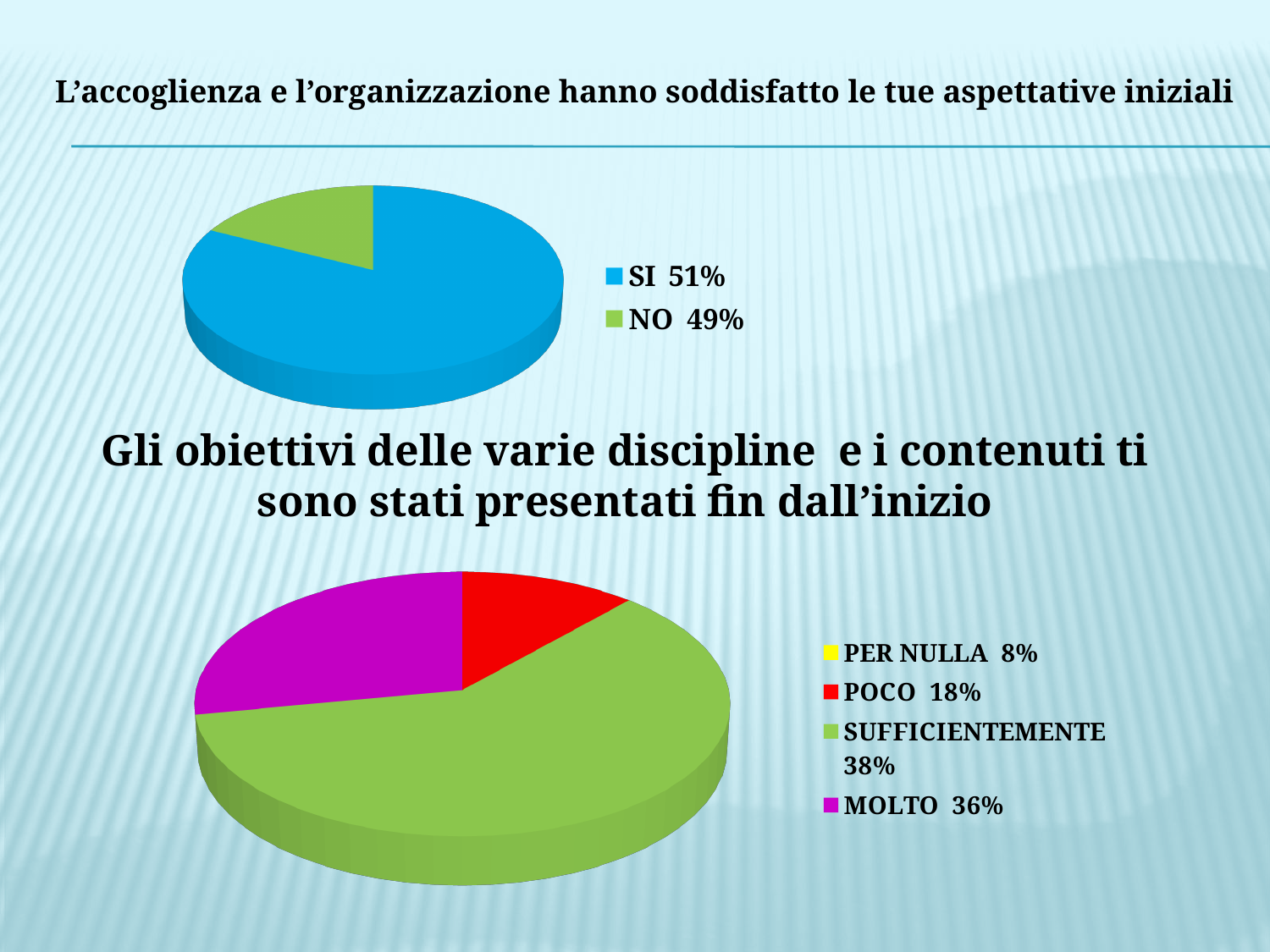
In the top chart, what is the difference between the SI and NO percentages? 2% In the bottom chart, what percentage is shown for MOLTO? 36% What kind of chart is the top chart? Pie chart In the bottom chart, how many categories does the legend list? 4 In the bottom chart, what percentage is shown for SUFFICIENTEMENTE? 38% In the top chart, which category has the larger share? SI In the top chart, what percentage is shown for NO? 49% In the bottom chart, which category has the smallest share? PER NULLA In the bottom chart, which category has the largest share? SUFFICIENTEMENTE In the bottom chart, what is the difference between the SUFFICIENTEMENTE and POCO percentages? 20% In the bottom chart, what percentage is shown for POCO? 18% In the top chart, what percentage is shown for SI? 51%